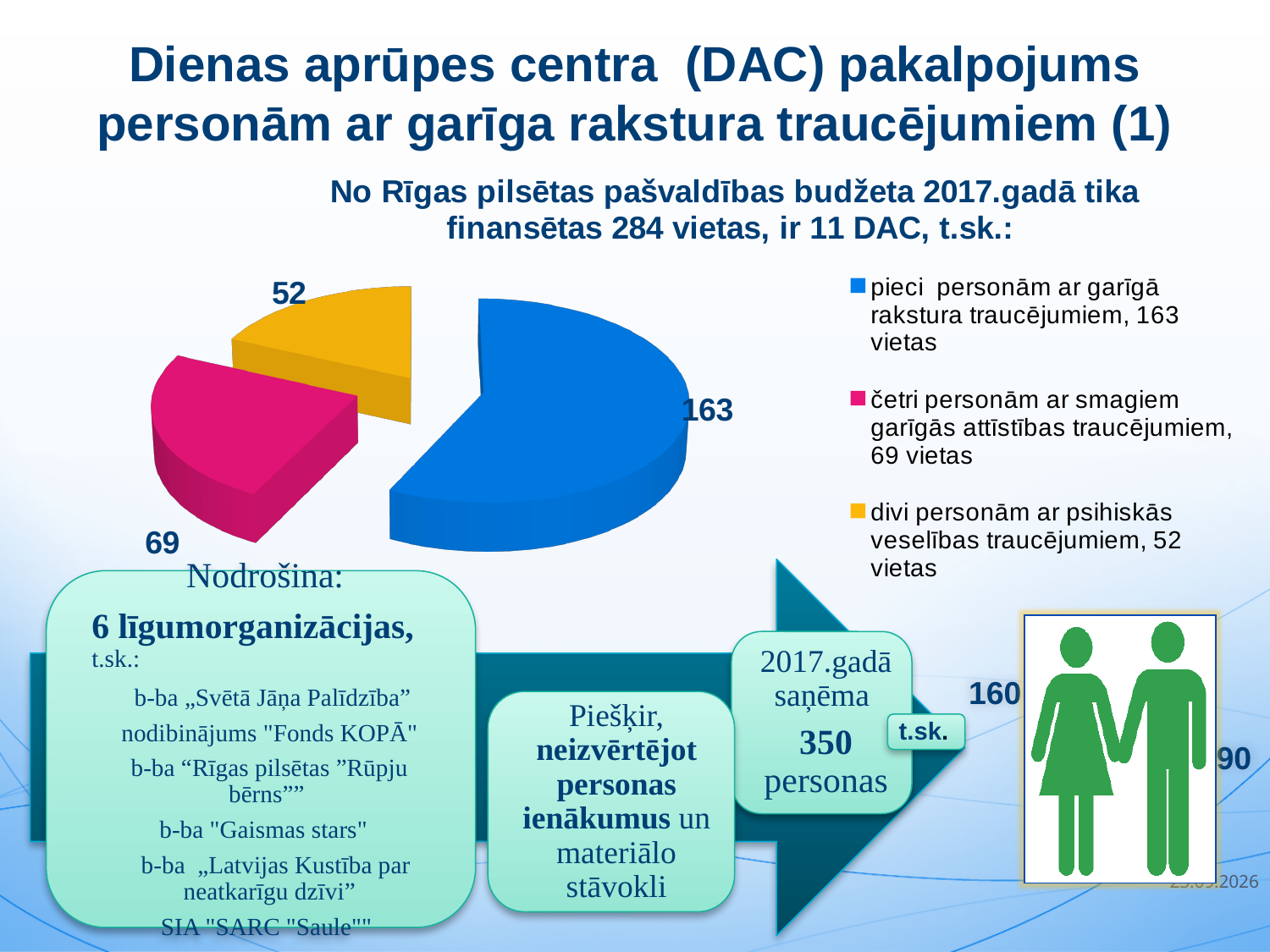
Which is larger: the slice for "četri personām ar smagiem garīgās attīstības traucējumiem" or the slice for "divi personām ar psihiskās veselības traucējumiem"? četri personām ar smagiem garīgās attīstības traucējumiem What value is shown for the slice "četri personām ar smagiem garīgās attīstības traucējumiem"? 69 What kind of chart is shown on the slide? pie chart What value is shown for the slice "divi personām ar psihiskās veselības traucējumiem"? 52 How many entries does the pie chart's legend list? 3 What colour is the slice labelled 163 in the pie chart? blue How many slices does the pie chart have? 3 Which slice of the pie chart has the largest value? pieci personām ar garīgā rakstura traucējumiem What is the difference between the largest slice (163) and the smallest slice (52)? 111 What value is shown for the slice "pieci personām ar garīgā rakstura traucējumiem"? 163 What is the total of all three slices in the pie chart? 284 Which slice of the pie chart has the smallest value? divi personām ar psihiskās veselības traucējumiem